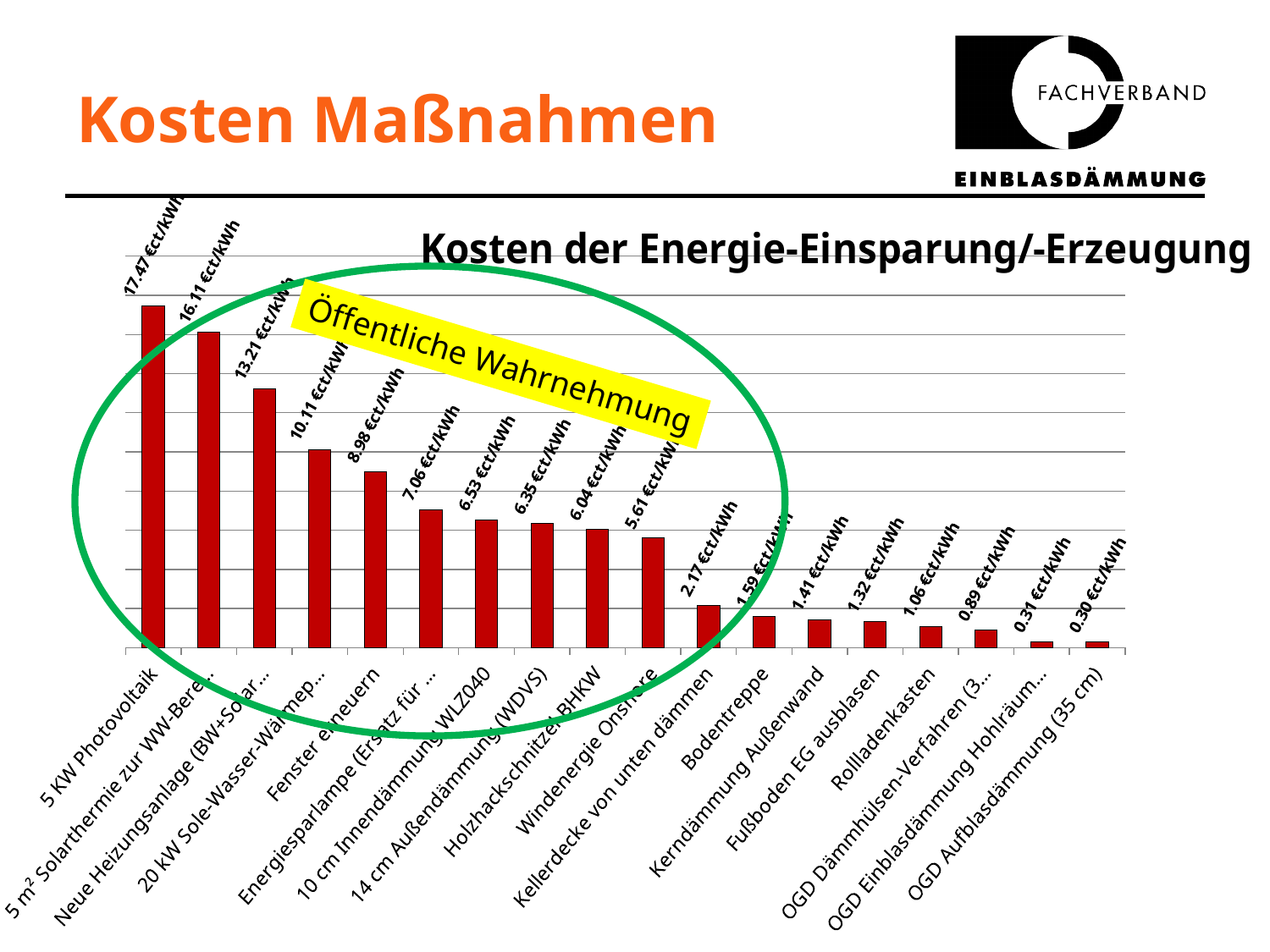
What is the value for 5 KW Photovoltaik? 17.47 €ct/kWh What is the title of the chart? Kosten der Energie-Einsparung/-Erzeugung Which category has the lowest value? OGD Aufblasdämmung (35 cm) What is the value for Kerndämmung Außenwand? 1.41 €ct/kWh Which category has the highest value? 5 KW Photovoltaik What is the difference between the values for 14 cm Außendämmung (WDVS) and Kellerdecke von unten dämmen? 4.18 €ct/kWh What type of chart is shown on the slide? bar chart Which has a larger value, Windenergie Onshore or Rollladenkasten? Windenergie Onshore What is the value for Bodentreppe? 1.59 €ct/kWh What is the value for Fenster erneuern? 8.98 €ct/kWh Do the bar values rise or fall from left to right along the x axis? fall How many bars (categories) does the chart show? 18